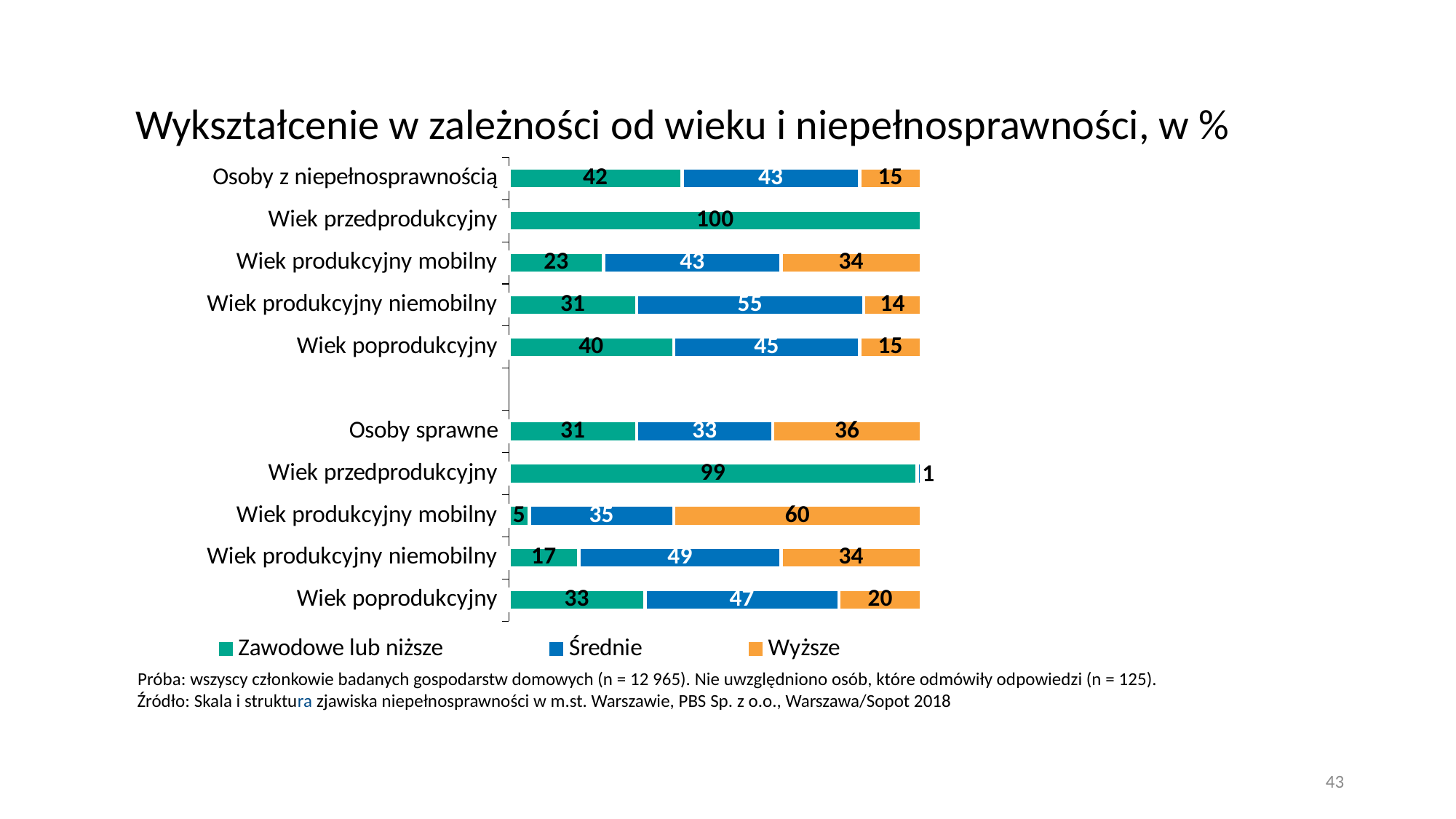
Which category has the highest "Wyższe" value? Wiek produkcyjny mobilny (Osoby sprawne) What is the value of "Wyższe" for "Osoby sprawne"? 36 How many series does the legend list? 3 What is the value of "Wyższe" for "Wiek produkcyjny mobilny" in the "Osoby z niepełnosprawnością" group? 34 What is the difference between the "Wyższe" values for "Osoby sprawne" and "Osoby z niepełnosprawnością"? 21 What is the value of "Średnie" for "Osoby z niepełnosprawnością"? 43 What kind of chart is shown on the slide? Stacked bar chart Which category has the highest "Średnie" value? Wiek produkcyjny niemobilny (Osoby z niepełnosprawnością) Which is larger: the "Zawodowe lub niższe" value for "Wiek poprodukcyjny" in the "Osoby z niepełnosprawnością" group or in the "Osoby sprawne" group? Osoby z niepełnosprawnością (40) What is the title of the chart? Wykształcenie w zależności od wieku i niepełnosprawności, w % What is the value of "Zawodowe lub niższe" for "Wiek produkcyjny mobilny" in the "Osoby sprawne" group? 5 What is the total of the stacked bar for "Wiek produkcyjny niemobilny" in the "Osoby sprawne" group? 100